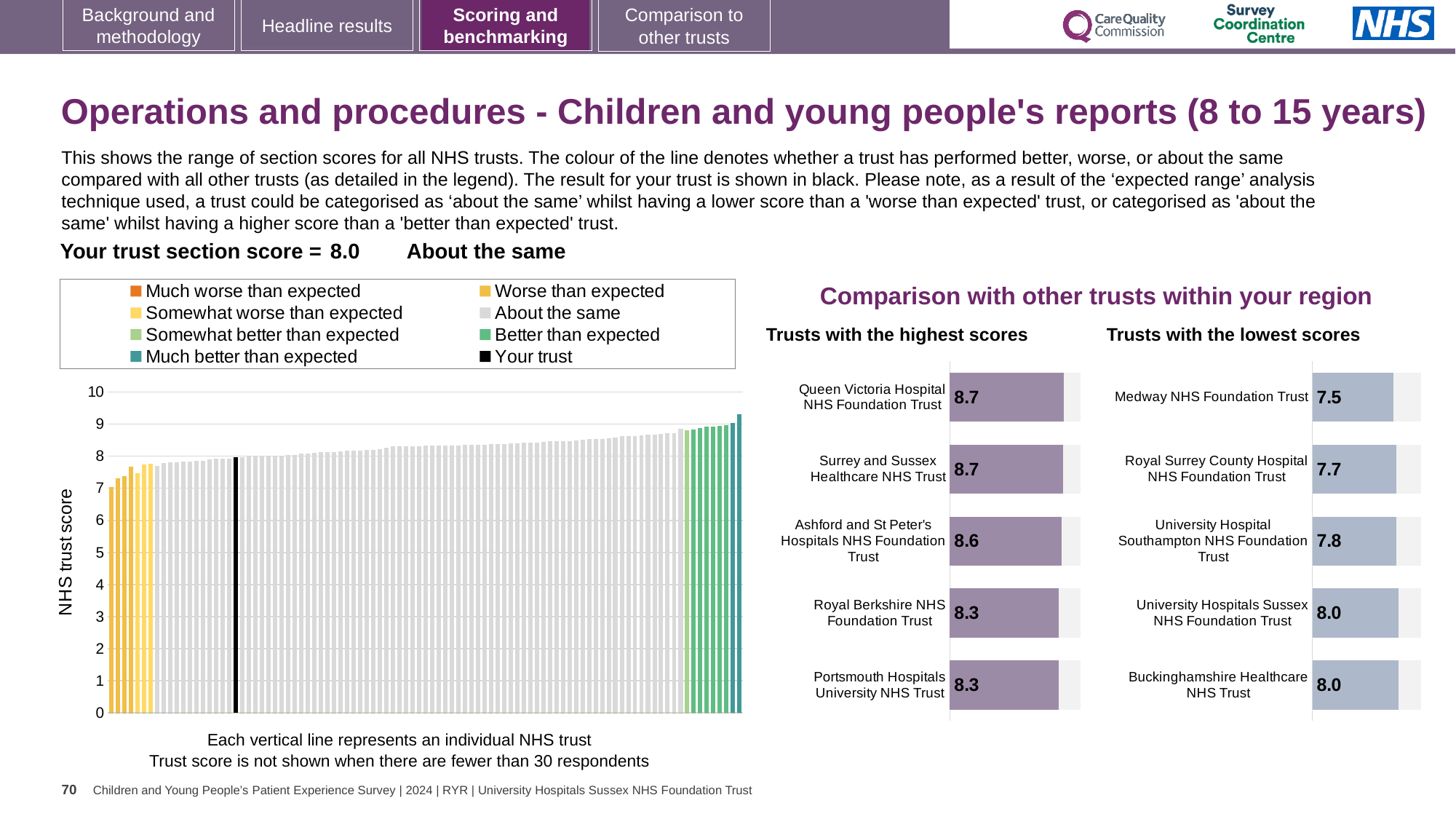
How many entries does the legend of the main NHS trust score chart list? 8 Which has the higher score: Royal Berkshire NHS Foundation Trust in the highest scores chart or Royal Surrey County Hospital NHS Foundation Trust in the lowest scores chart? Royal Berkshire NHS Foundation Trust In the main NHS trust score chart, what is the section score for your trust (shown in black)? 8.0 What is the label on the vertical axis of the main chart? NHS trust score In the 'Trusts with the highest scores' chart, what is the score for Ashford and St Peter's Hospitals NHS Foundation Trust? 8.6 In the 'Trusts with the highest scores' chart, what is the difference between the scores of Queen Victoria Hospital NHS Foundation Trust and Portsmouth Hospitals University NHS Trust? 0.4 In the 'Trusts with the lowest scores' chart, what is the score for Medway NHS Foundation Trust? 7.5 In the main NHS trust score chart, do the values rise or fall from left to right? Rise How many trusts are shown in the 'Trusts with the highest scores' chart? 5 What kind of chart is the main chart showing the NHS trust score for all trusts? Bar chart In the 'Trusts with the lowest scores' chart, what is the difference between the scores of University Hospital Southampton NHS Foundation Trust and Medway NHS Foundation Trust? 0.3 In the 'Trusts with the lowest scores' chart, which trust has the lowest score? Medway NHS Foundation Trust